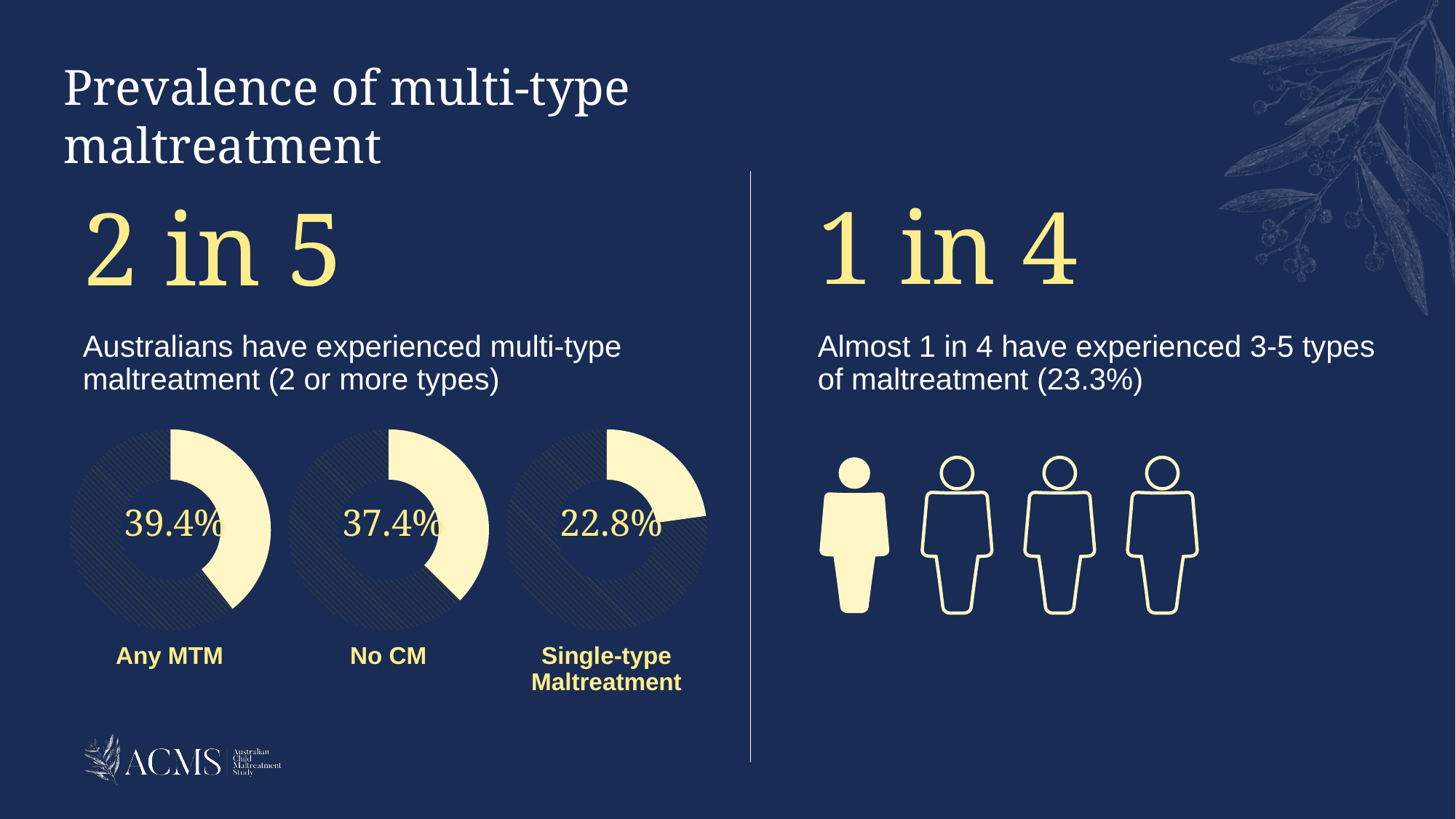
What value is shown on the Any MTM donut chart? 39.4% On the donut charts, which is larger: the value for No CM or the value for Single-type Maltreatment? No CM What is the difference between the Any MTM value and the No CM value on the donut charts? 2.0% What value is shown on the No CM donut chart? 37.4% What value is shown on the Single-type Maltreatment donut chart? 22.8% How many donut charts are shown on the left side of the slide? 3 Among the three donut charts, which category has the highest value? Any MTM What kind of chart is used to show the Any MTM, No CM and Single-type Maltreatment values? Donut chart Among the three donut charts, which category has the lowest value? Single-type Maltreatment In the pictogram on the right side of the slide, how many person icons are shown in total? 4 What is the difference between the No CM value and the Single-type Maltreatment value on the donut charts? 14.6% In the pictogram on the right side of the slide, how many of the person icons are filled in? 1